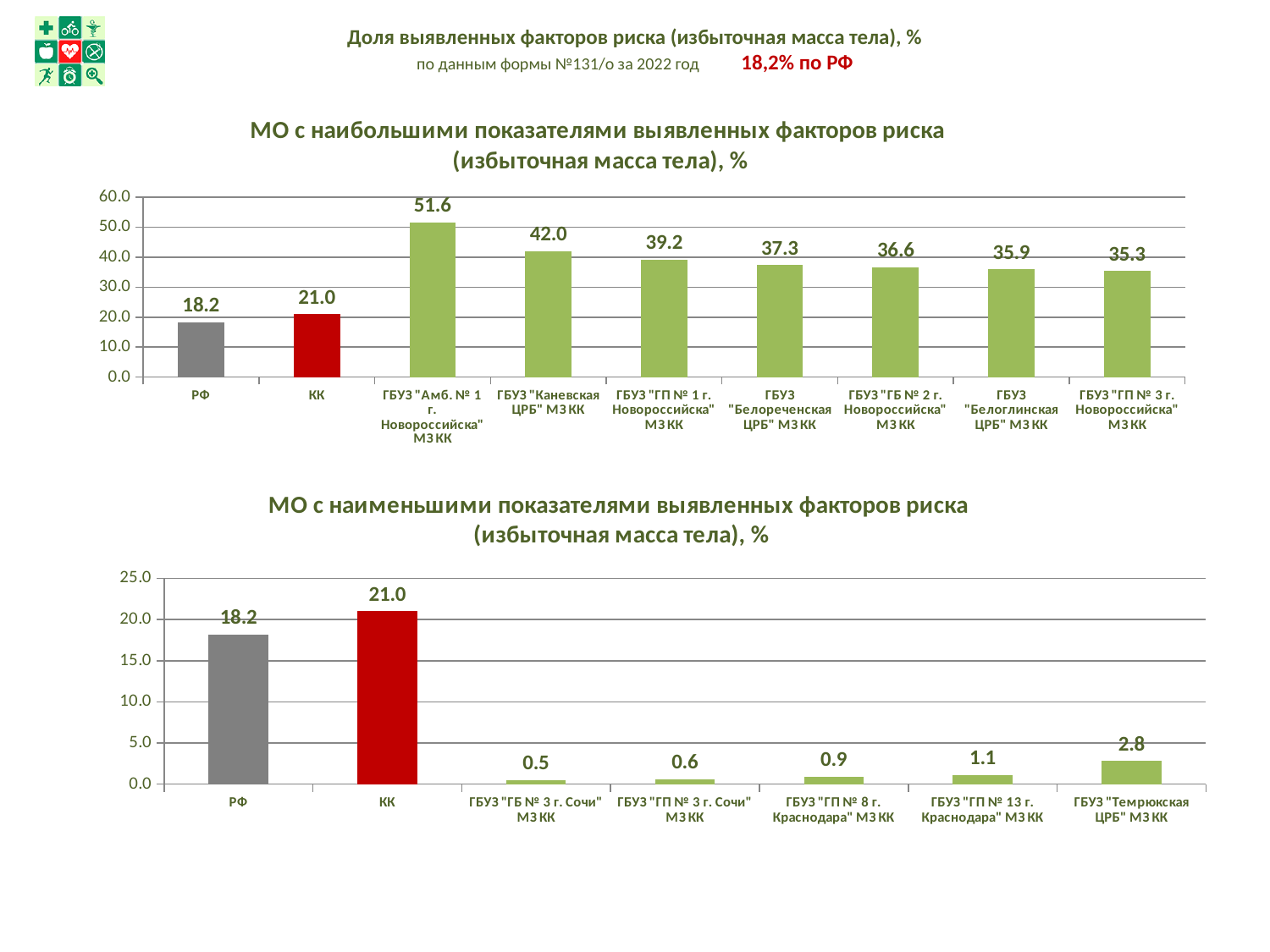
What kind of chart is the bottom chart (МО с наименьшими показателями)? Bar chart In the top chart (МО с наибольшими показателями), which is larger: ГБУЗ "Белореченская ЦРБ" МЗ КК or ГБУЗ "ГП № 3 г. Новороссийска" МЗ КК? ГБУЗ "Белореченская ЦРБ" МЗ КК In the bottom chart (МО с наименьшими показателями), how many bars are plotted? 7 In the bottom chart (МО с наименьшими показателями), what colour is the bar for КК? Red In the top chart (МО с наибольшими показателями), what is the difference between ГБУЗ "Амб. № 1 г. Новороссийска" МЗ КК and КК? 30.6 In the top chart (МО с наибольшими показателями), what is the value for ГБУЗ "Каневская ЦРБ" МЗ КК? 42.0 In the bottom chart (МО с наименьшими показателями), what is the value for ГБУЗ "Темрюкская ЦРБ" МЗ КК? 2.8 In the bottom chart (МО с наименьшими показателями), which category has the lowest value? ГБУЗ "ГБ № 3 г. Сочи" МЗ КК In the bottom chart (МО с наименьшими показателями), what is the difference between КК and РФ? 2.8 In the top chart (МО с наибольшими показателями), how many bars are plotted? 9 In the top chart (МО с наибольшими показателями), which category has the highest value? ГБУЗ "Амб. № 1 г. Новороссийска" МЗ КК In the top chart (МО с наибольшими показателями), what is the value for ГБУЗ "Белоглинская ЦРБ" МЗ КК? 35.9